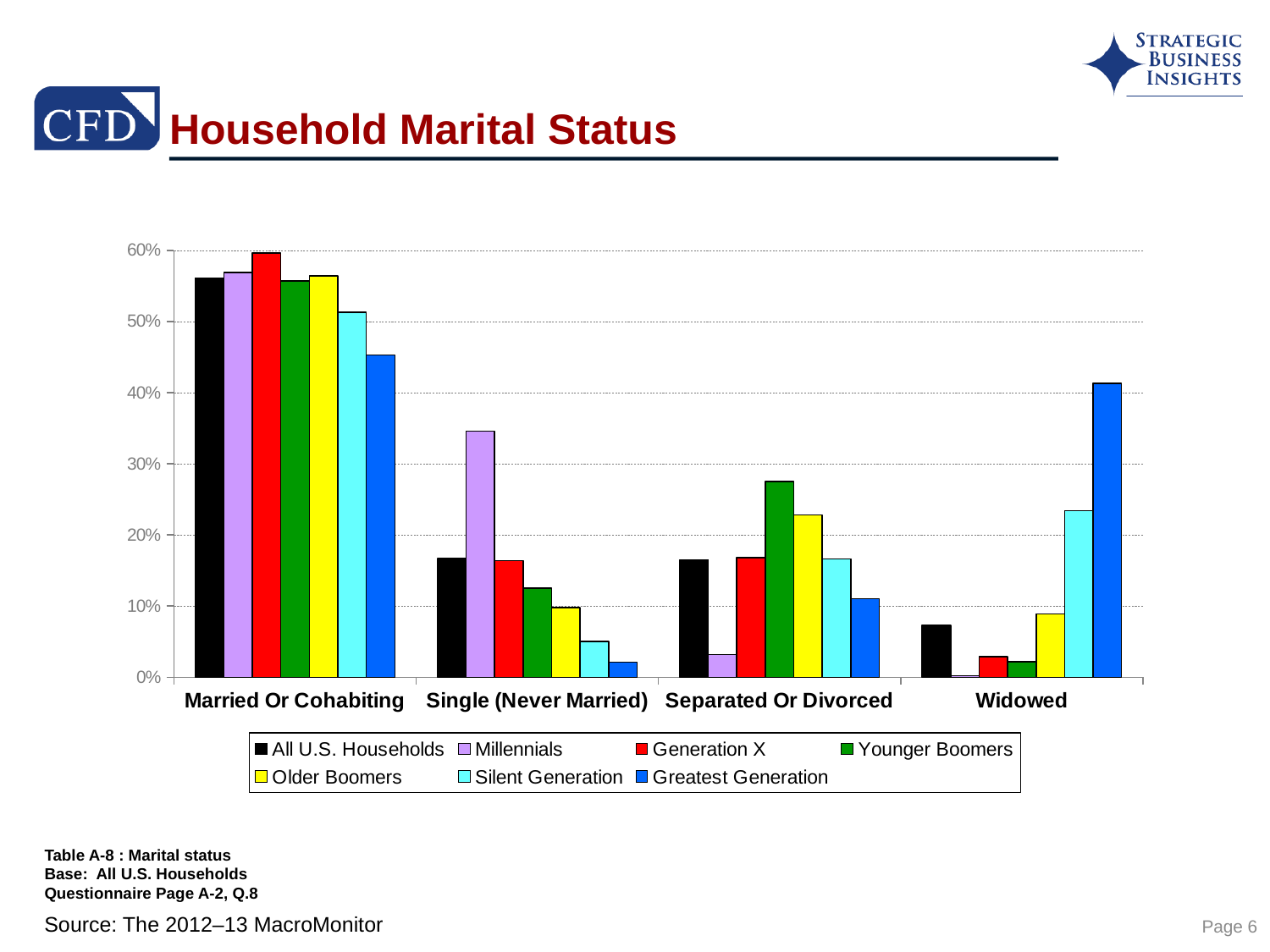
In Separated Or Divorced, which is larger: Younger Boomers or Older Boomers? Younger Boomers How many marital status categories are shown on the x axis? 4 Is the value for Millennials in Single (Never Married) greater or less than 30%? greater Is the value for Greatest Generation in Married Or Cohabiting greater or less than 50%? less What kind of chart is shown on the slide? Bar chart Which generation has the lowest value for Married Or Cohabiting? Greatest Generation Is the value for Greatest Generation in Widowed greater or less than 30%? greater What colour represents Generation X in the legend? Red Which generation has the highest value for Separated Or Divorced? Younger Boomers Which generation has the highest value for Single (Never Married)? Millennials How many series does the legend list? 7 Which generation has the highest value for Widowed? Greatest Generation